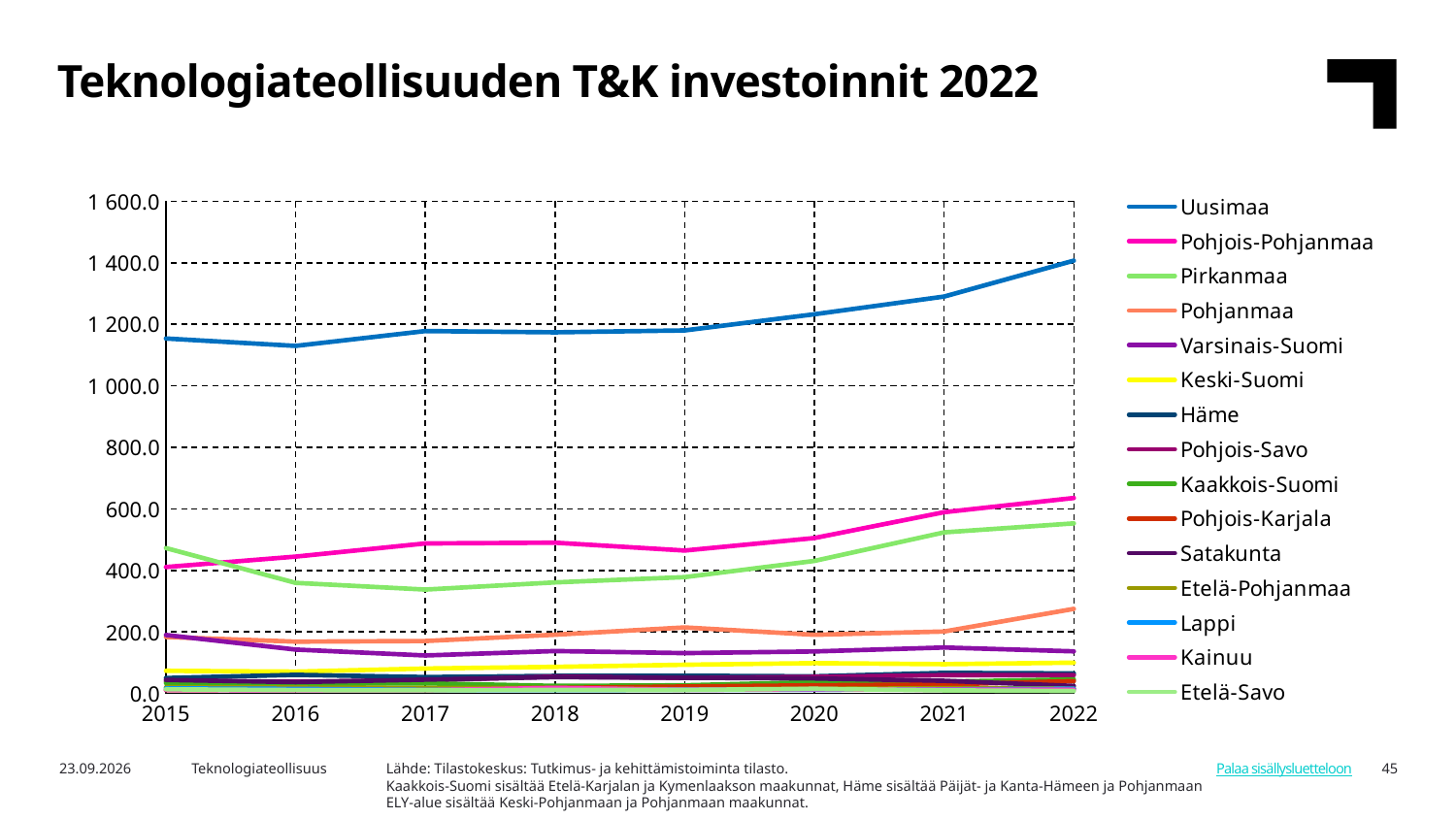
Is the value for Pohjanmaa in 2022 greater or less than 200.0? greater What kind of chart is shown on the slide? line chart Is the value for Uusimaa in 2015 greater or less than 1 000.0? greater Which is larger in 2022, the value for Pohjois-Pohjanmaa or the value for Pirkanmaa? Pohjois-Pohjanmaa Is the value for Pohjois-Pohjanmaa in 2022 greater or less than 600.0? greater Does the value for Uusimaa rise or fall from 2019 to 2022? rise What is the title of the chart slide? Teknologiateollisuuden T&K investoinnit 2022 How many years are shown on the x axis? 8 Which region has the highest R&D investment in 2022? Uusimaa Which is larger in 2015, the value for Pirkanmaa or the value for Pohjois-Pohjanmaa? Pirkanmaa How many series does the legend list? 15